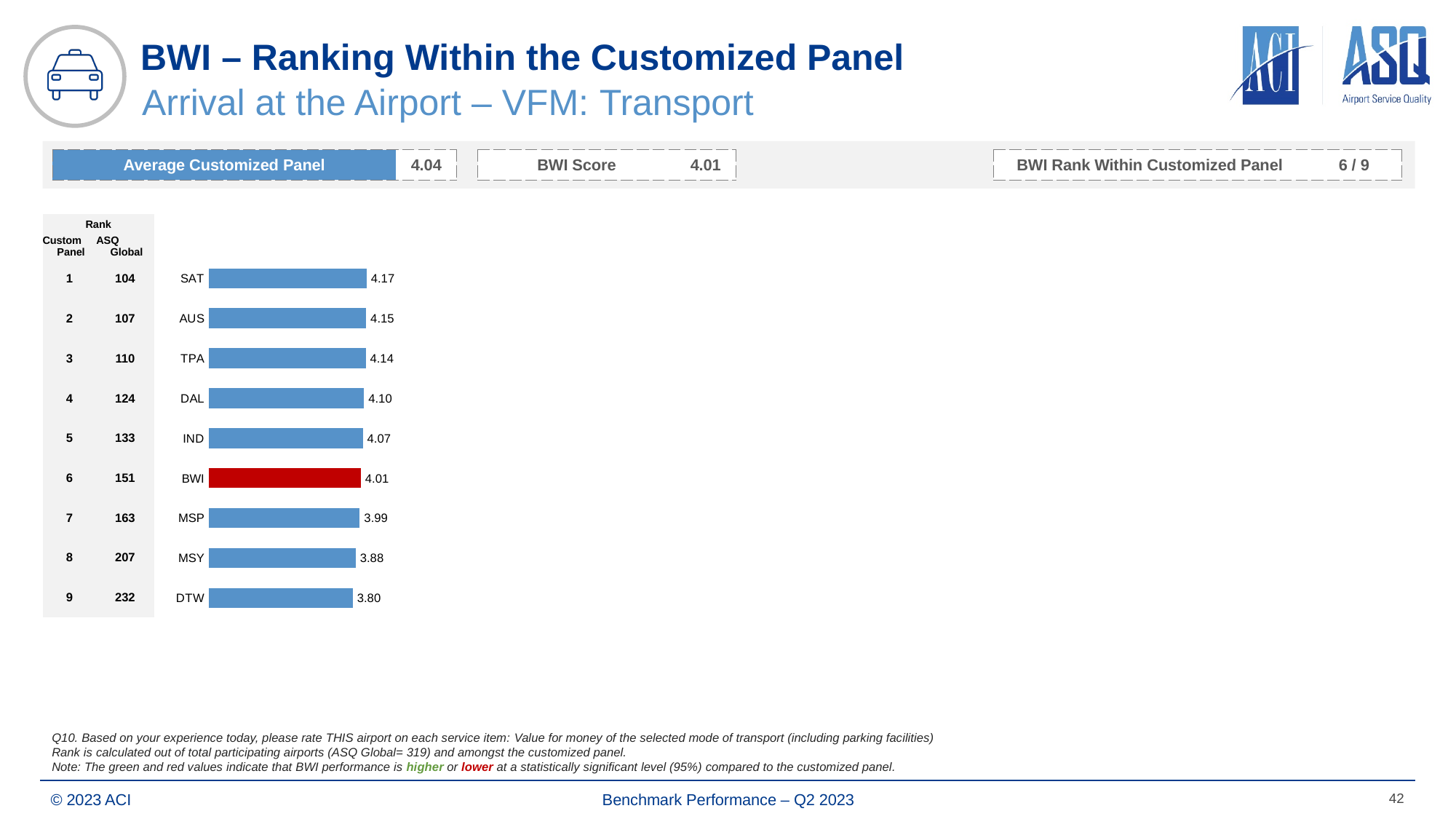
What is the difference between the values for BWI and MSP? 0.02 Which bar is coloured red? BWI What is the difference between the values for SAT and DTW? 0.37 What is the value for SAT? 4.17 What is the value for BWI? 4.01 What kind of chart is shown on the slide? Bar chart Do the values rise or fall going from the top bar to the bottom bar? Fall Which airport has the highest value? SAT How many airports are shown in the chart? 9 Which is larger, the value for AUS or the value for IND? AUS Which airport has the lowest value? DTW What is the value for MSY? 3.88